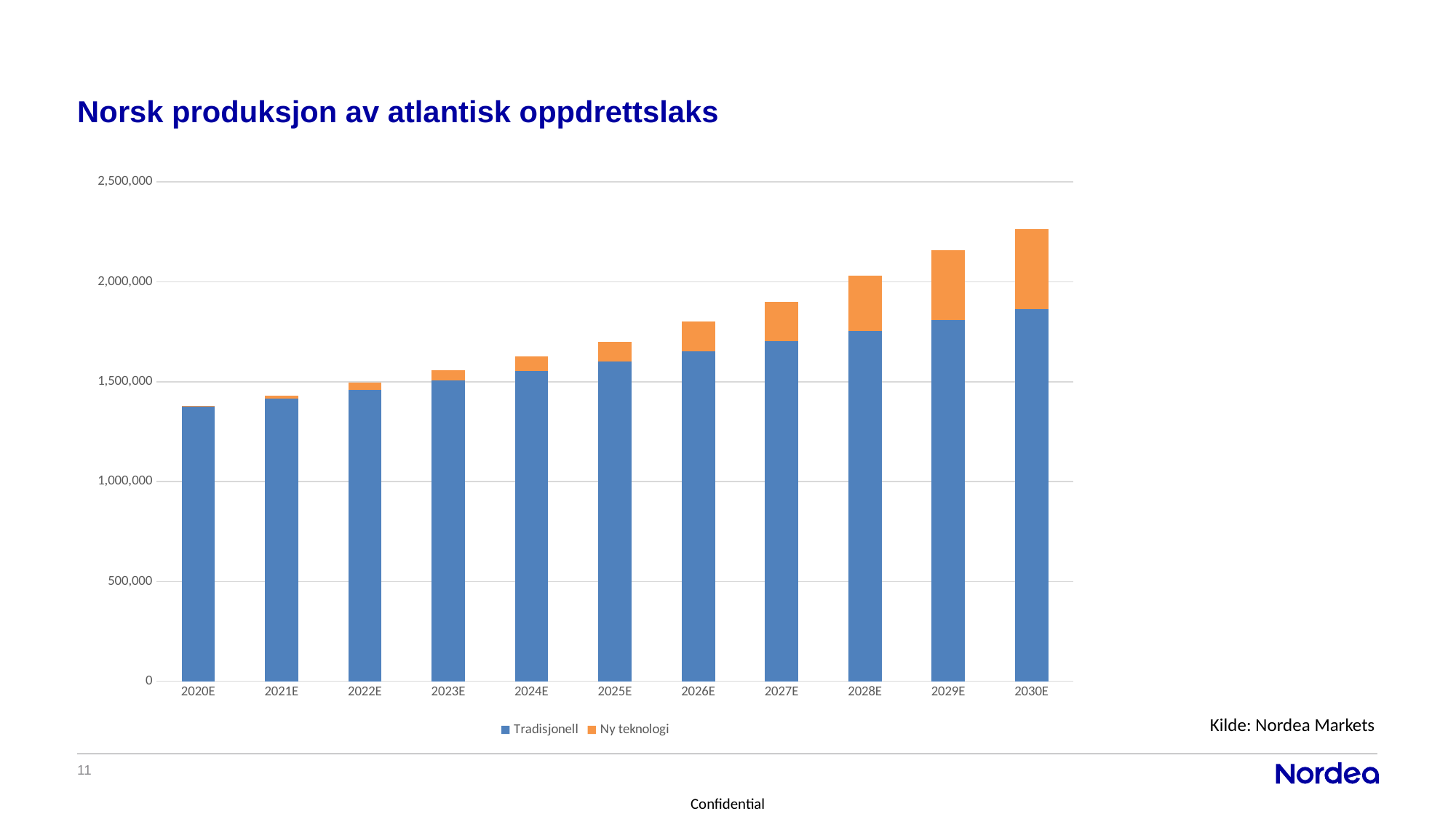
Is the total value for 2027E greater or less than 2,000,000? less Is the Tradisjonell value for 2029E greater or less than 2,000,000? less Which series is shown in orange in the chart? Ny teknologi Is the total value for 2020E greater or less than 1,500,000? less Which is larger, the total for 2030E or the total for 2020E? 2030E Which year has the lowest total production in the chart? 2020E What kind of chart is shown on the slide? Stacked bar chart Do the total bar heights rise or fall from 2020E to 2030E? Rise How many years are shown on the x axis of the chart? 11 Which year has the highest total production in the chart? 2030E How many series does the legend list? 2